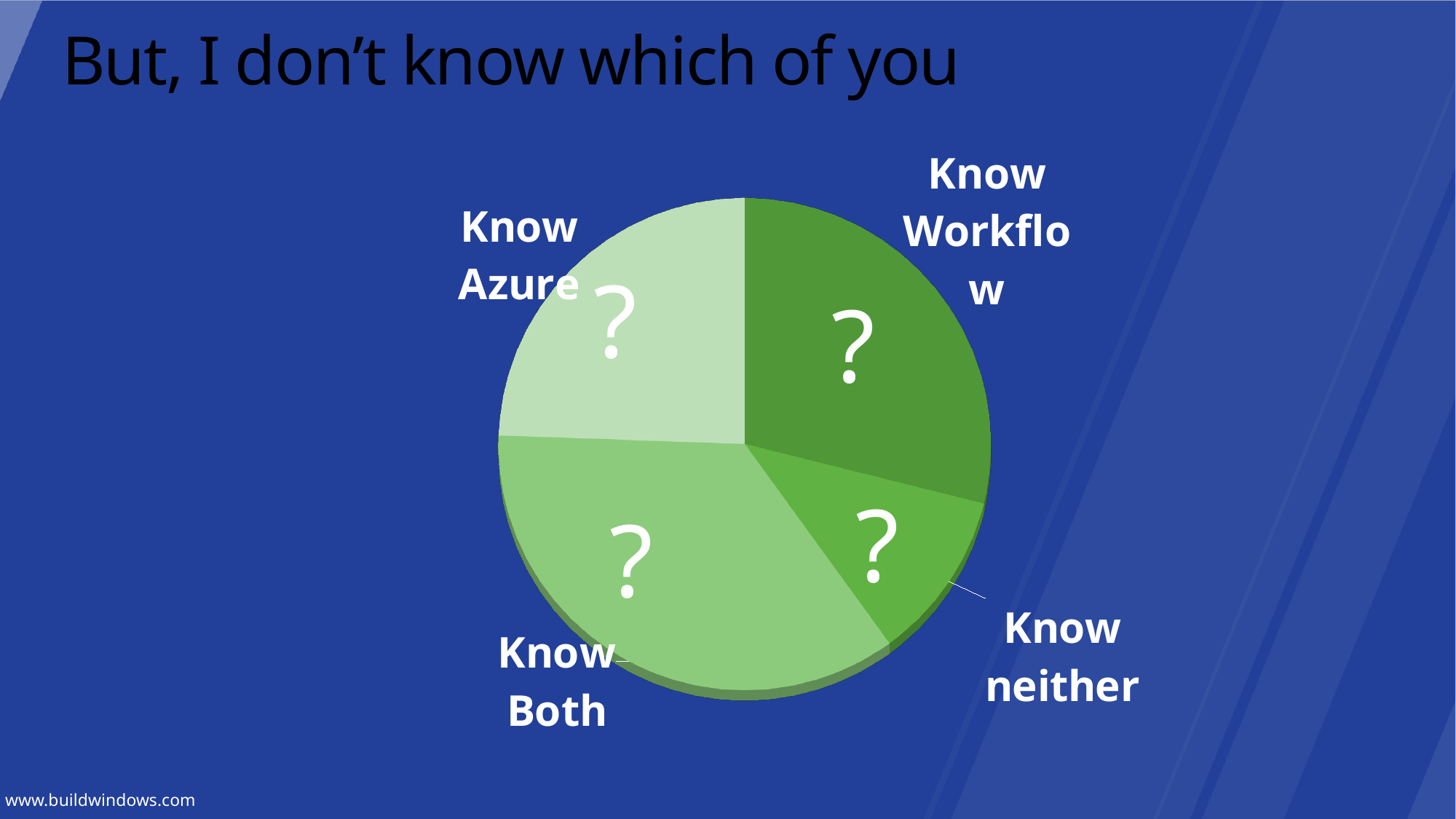
Which slice is larger, Know Workflow or Know neither? Know Workflow What symbol is shown as the data label on each slice of the pie chart? ? What is the title of the slide containing the pie chart? But, I don't know which of you What kind of chart is shown on the slide? pie chart Which slice of the pie chart is the smallest? Know neither Which slice of the pie chart is the largest? Know Both Which slice is larger, Know Both or Know Azure? Know Both Which slice is larger, Know Azure or Know neither? Know Azure How many slices does the pie chart have? 4